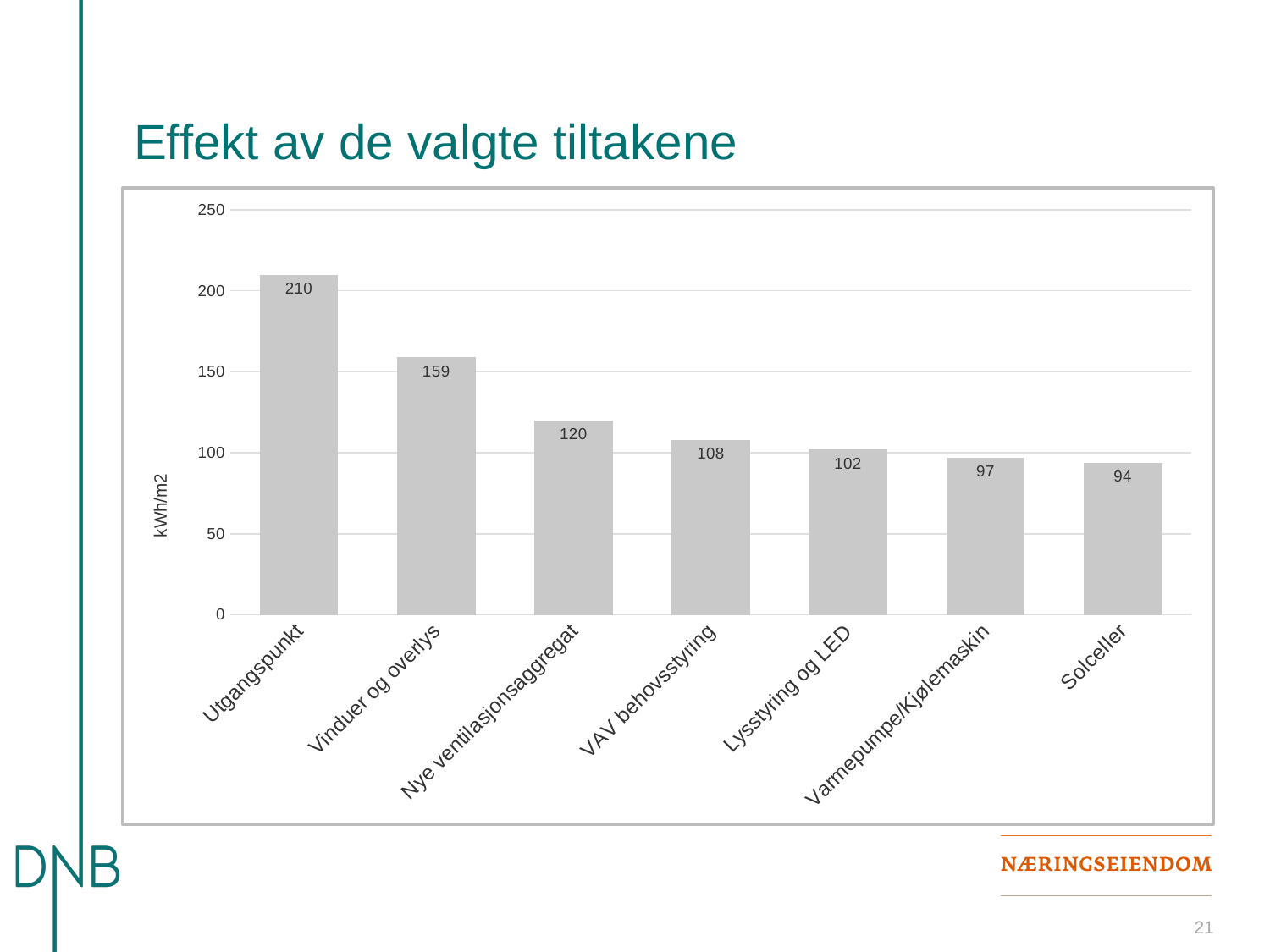
Which is larger, the value for Nye ventilasjonsaggregat or the value for Varmepumpe/Kjølemaskin? Nye ventilasjonsaggregat What is the value for Vinduer og overlys? 159 What is the value for Solceller? 94 Which category has the highest value? Utgangspunkt What is the value for Utgangspunkt? 210 What kind of chart is shown on the slide? Bar chart Do the values rise or fall from left to right along the x axis? Fall How many categories are shown on the x axis? 7 What is the difference between the values for Utgangspunkt and Vinduer og overlys? 51 Which category has the lowest value? Solceller What is the difference between the values for VAV behovsstyring and Lysstyring og LED? 6 What is the value for Nye ventilasjonsaggregat? 120